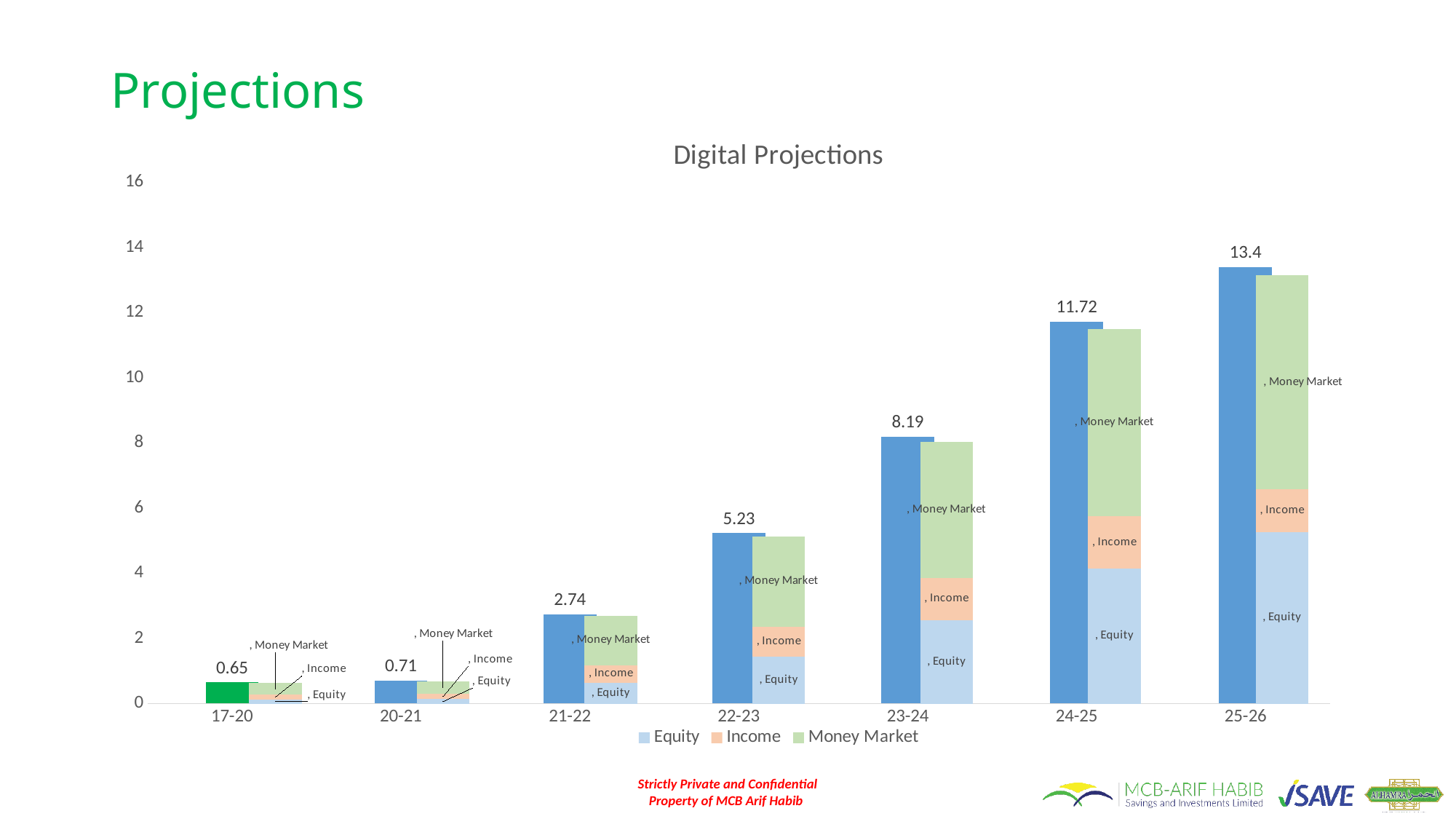
What is the labelled total value for 25-26 in the Digital Projections chart? 13.4 Which period has the highest labelled value in the Digital Projections chart? 25-26 Do the labelled values rise or fall from 17-20 to 25-26? rise Which period has the lowest labelled value in the Digital Projections chart? 17-20 How many series does the legend of the Digital Projections chart list? 3 What is the difference between the labelled values for 25-26 and 24-25? 1.68 Which is larger, the labelled value for 21-22 or for 20-21? 21-22 Is the labelled value for 24-25 greater or less than 10? greater How many periods are shown on the x axis of the Digital Projections chart? 7 What is the labelled value for 17-20 in the Digital Projections chart? 0.65 What is the labelled value for 22-23 in the Digital Projections chart? 5.23 What is the difference between the labelled values for 23-24 and 22-23? 2.96